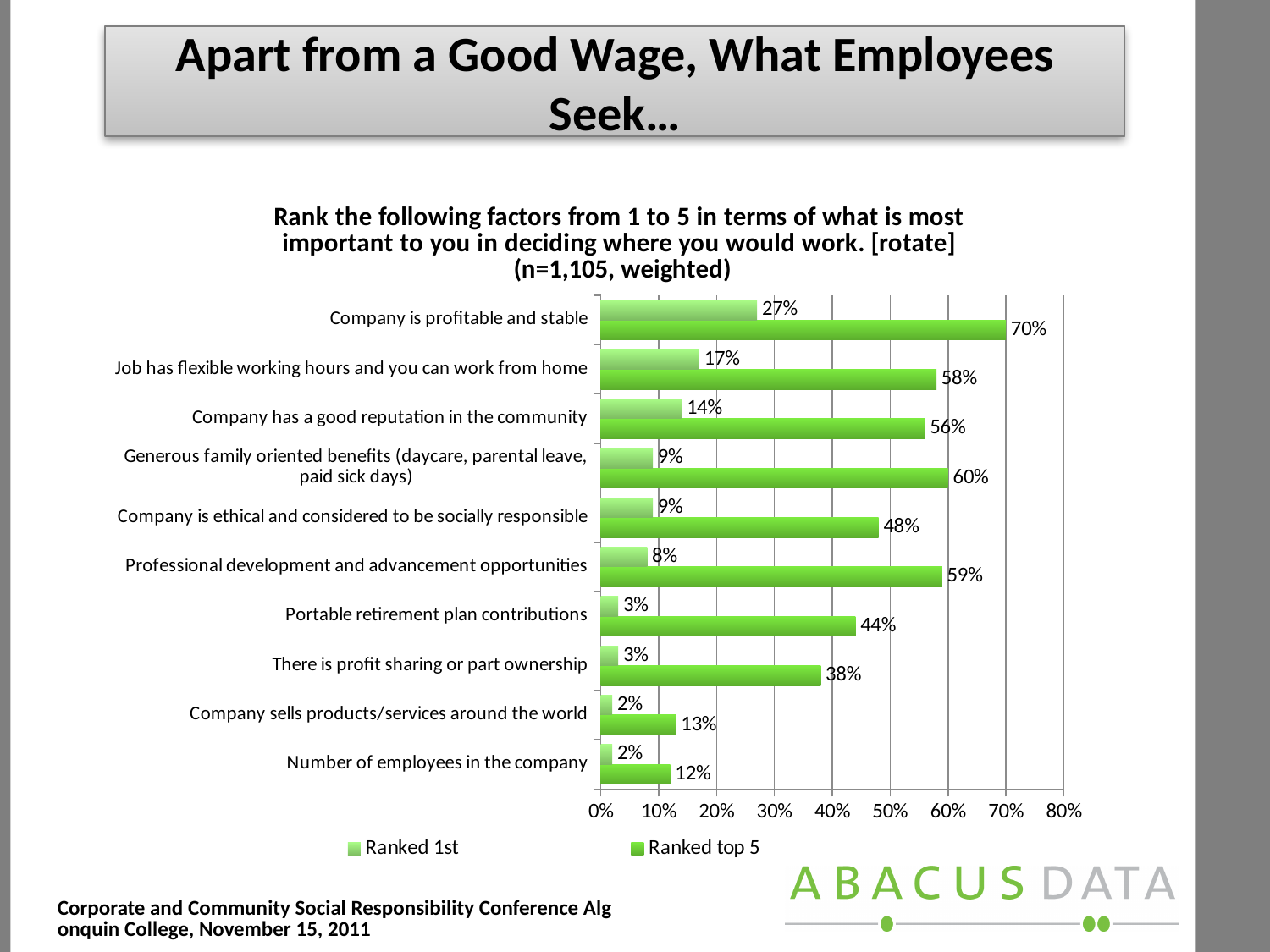
What percentage ranked "Company is profitable and stable" in their top 5? 70% Which factor has the lowest "Ranked top 5" value? Number of employees in the company How many factors are listed on the chart? 10 What are the two series named in the legend? Ranked 1st and Ranked top 5 Is the "Ranked top 5" value for "Portable retirement plan contributions" greater or less than 50%? less What kind of chart is shown on the slide? Bar chart What is the "Ranked top 5" value for "Generous family oriented benefits (daycare, parental leave, paid sick days)"? 60% What percentage ranked "Job has flexible working hours and you can work from home" 1st? 17% Which factor has the highest "Ranked top 5" value? Company is profitable and stable How many series does the legend list? 2 Which has a larger "Ranked top 5" value: "Company is ethical and considered to be socially responsible" or "Professional development and advancement opportunities"? Professional development and advancement opportunities What is the difference between the "Ranked top 5" and "Ranked 1st" values for "Company is profitable and stable"? 43%